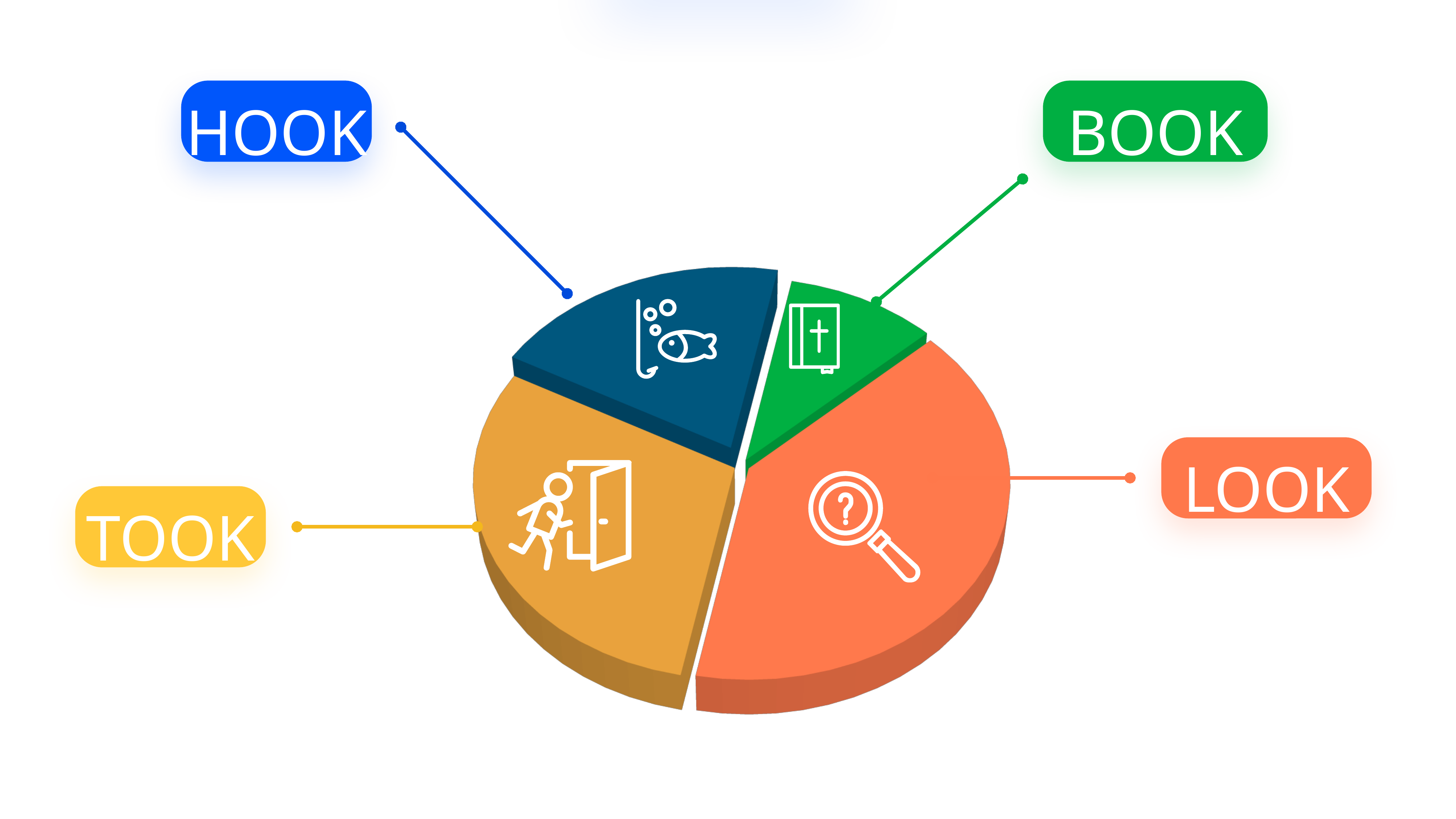
Which slice is larger, TOOK or HOOK? TOOK What kind of chart is shown on the slide? pie chart Which slice of the pie chart is coloured green? BOOK What colour is the HOOK slice of the pie chart? dark blue Which slice is larger, TOOK or BOOK? TOOK Which slice of the pie chart is the smallest? BOOK Which slice of the pie chart is the largest? LOOK Which slice is larger, LOOK or HOOK? LOOK How many slices does the pie chart have? 4